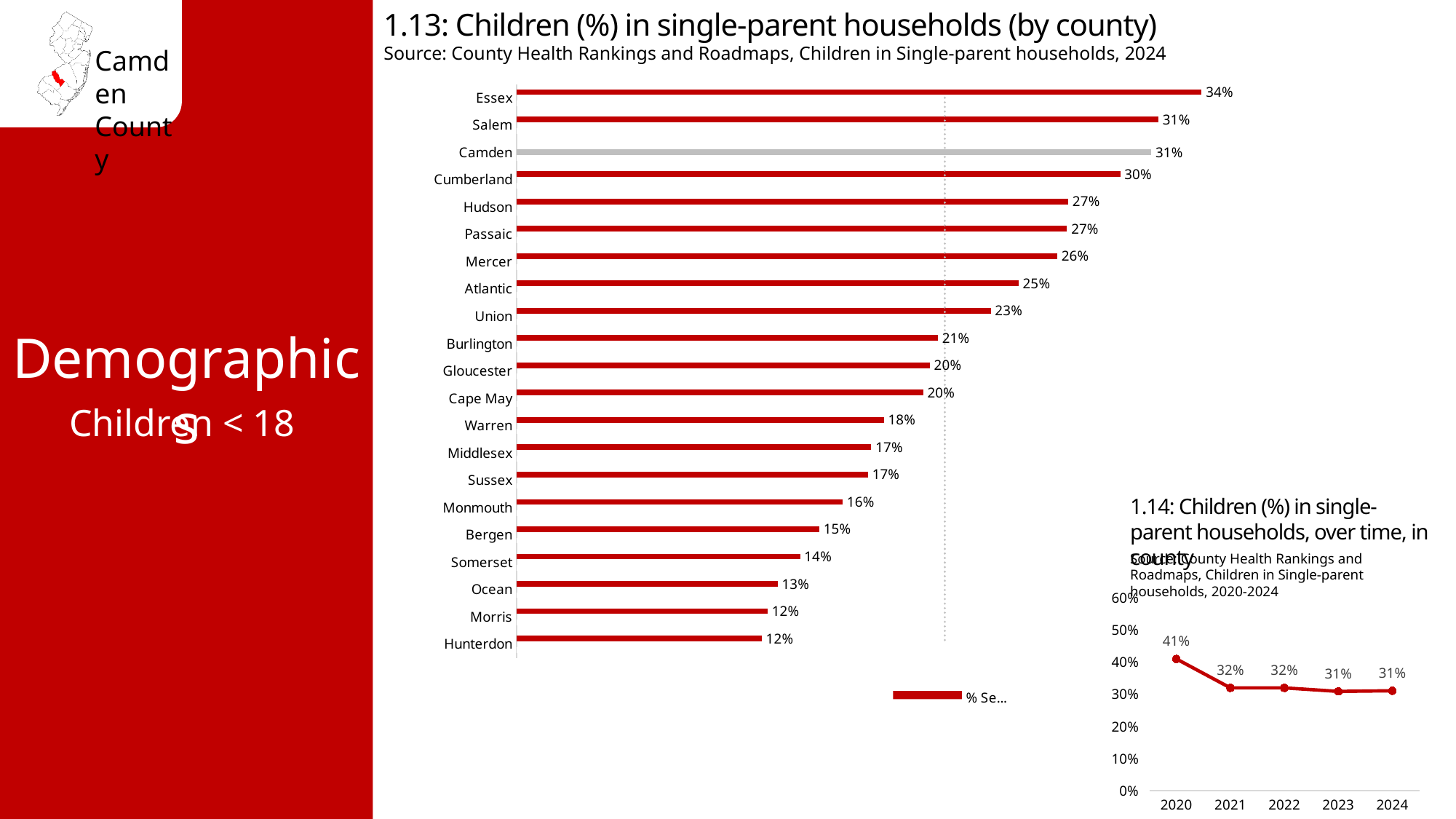
In chart 1.14 (over time, in county), what is the value for 2024? 31% In chart 1.14 (over time, in county), what is the value for 2020? 41% In chart 1.13 (by county), what is the difference between the values for Essex and Cumberland? 4% In chart 1.14 (over time, in county), what is the difference between the values for 2020 and 2021? 9% What kind of chart is chart 1.13 (by county)? Bar chart In chart 1.13 (Children (%) in single-parent households by county), what is the value for Essex? 34% In chart 1.13 (by county), which is larger, the value for Hudson or the value for Union? Hudson In chart 1.14 (over time, in county), do the values rise or fall from 2020 to 2024? Fall In chart 1.13 (by county), which county has the highest value? Essex In chart 1.13 (by county), what is the value for Camden? 31% In chart 1.13 (by county), how many counties are shown? 21 In chart 1.13 (by county), what is the value for Hunterdon? 12%